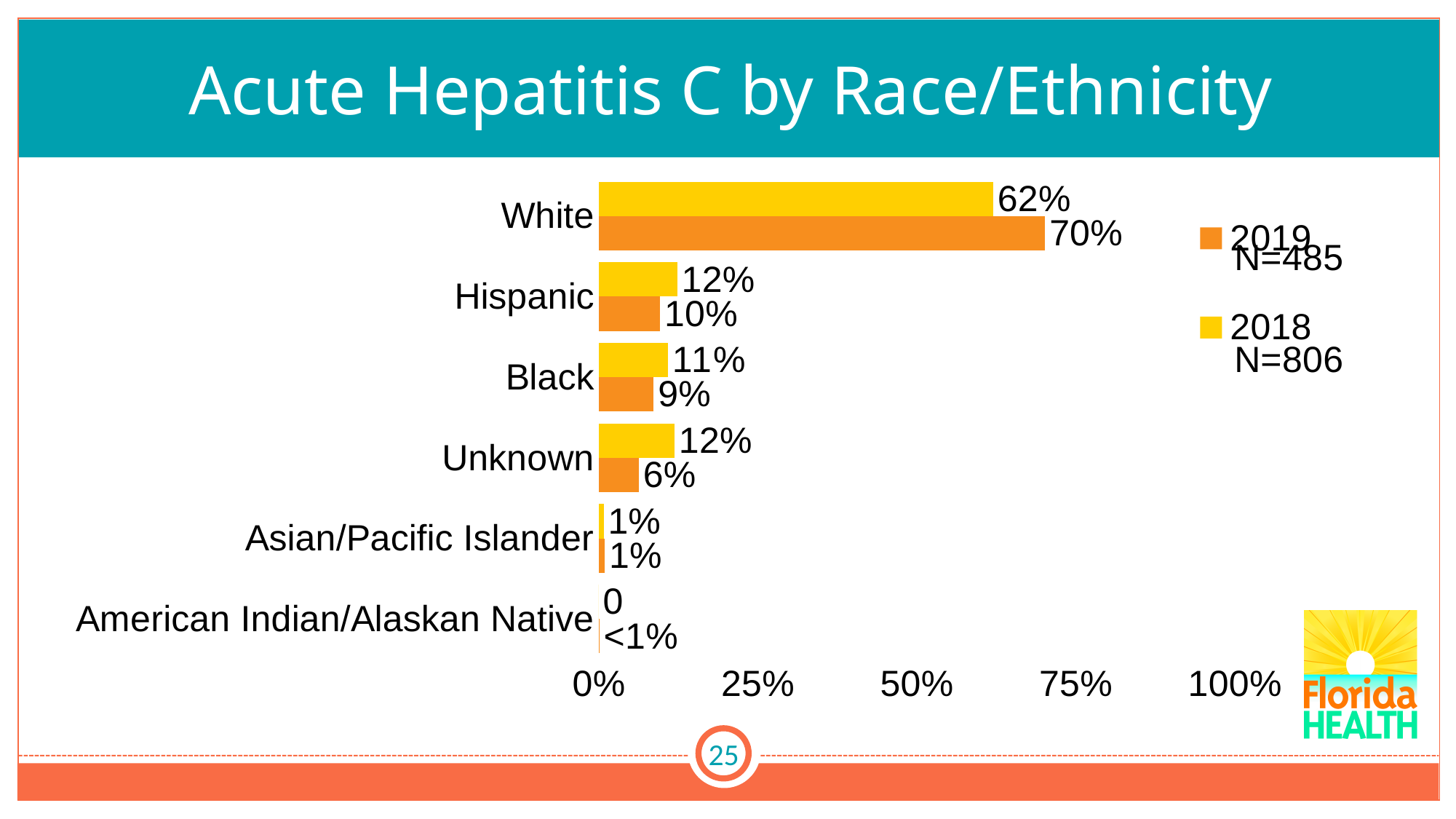
What type of chart is shown on the slide? Bar chart Which race/ethnicity category has the highest share of cases in 2019? White What is the difference between the 2018 and 2019 values for Unknown? 6% What is the 2018 value for Black? 11% What is the 2019 value for Unknown race/ethnicity? 6% What is the difference between the 2019 and 2018 values for White? 8% Which race/ethnicity category has the lowest value in 2018? American Indian/Alaskan Native What percentage of acute hepatitis C cases were White in 2019? 70% How many race/ethnicity categories are shown on the chart? 6 What percentage of acute hepatitis C cases were White in 2018? 62% How many series does the legend list? 2 Which is larger for Hispanic: the 2018 value or the 2019 value? 2018